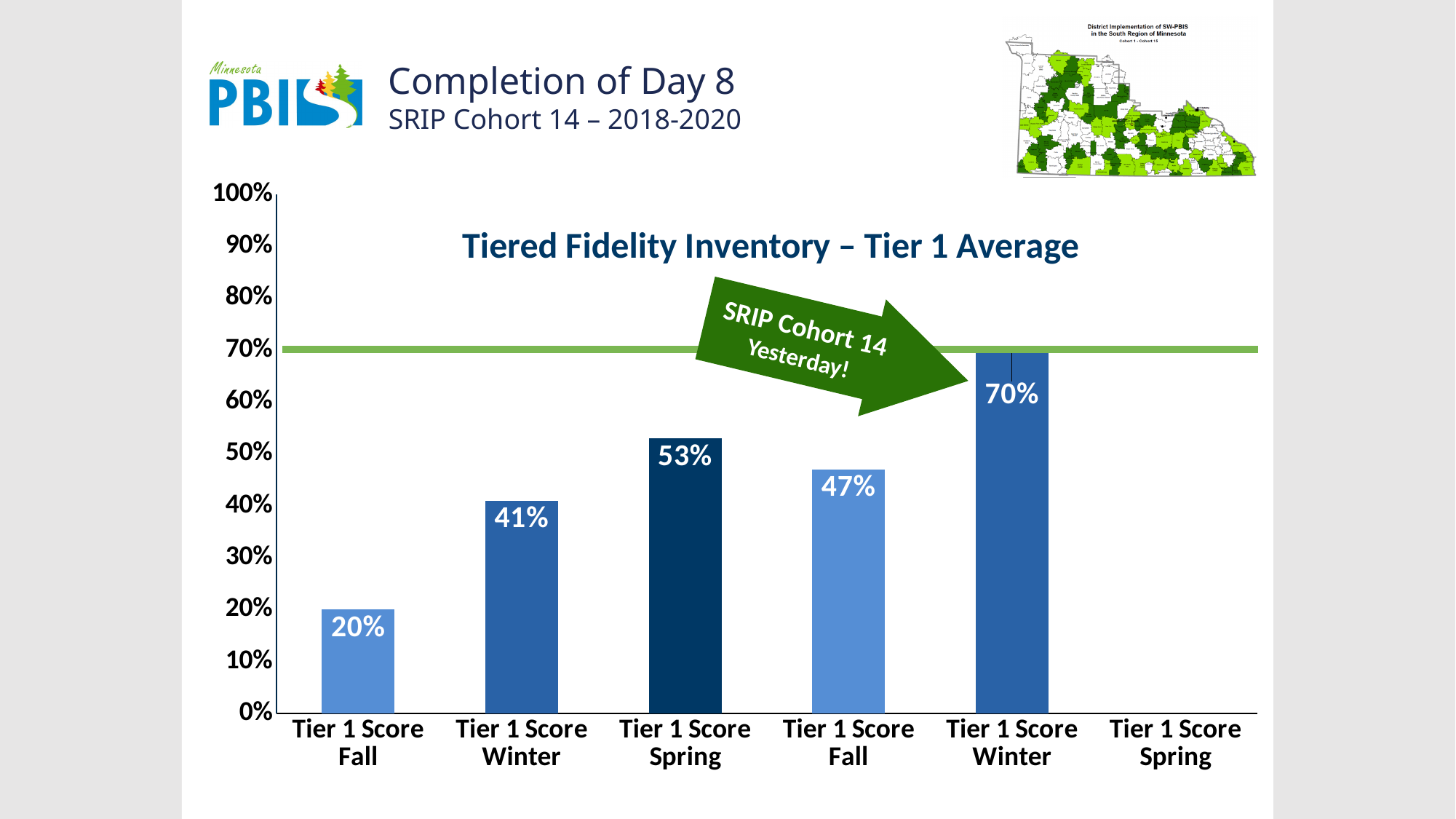
What is the value of the first Tier 1 Score Winter bar? 41% What is the title of the chart? Tiered Fidelity Inventory – Tier 1 Average What is the value of the first Tier 1 Score Spring bar? 53% What is the difference between the second Tier 1 Score Winter bar and the first Tier 1 Score Spring bar? 17% What kind of chart is shown on the slide? bar chart Which bar has the highest value? the second Tier 1 Score Winter bar (70%) Which bar has the lowest value? the first Tier 1 Score Fall bar (20%) How many category labels are shown on the x axis? 6 What is the value of the second Tier 1 Score Winter bar? 70% What is the value of the first Tier 1 Score Fall bar? 20% What is the value of the second Tier 1 Score Fall bar? 47% Which is larger, the first Tier 1 Score Spring bar or the second Tier 1 Score Fall bar? the first Tier 1 Score Spring bar